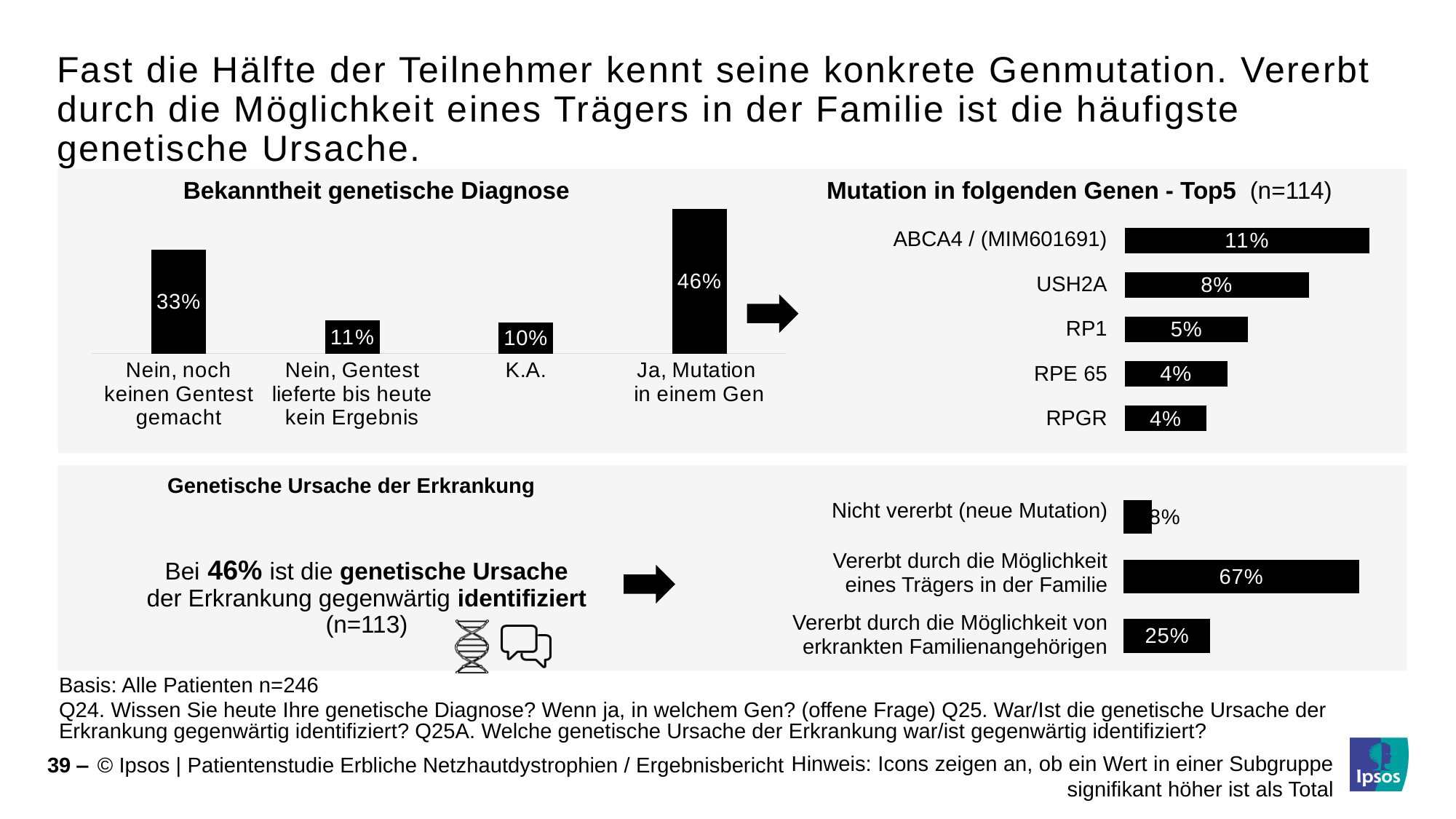
In the 'Genetische Ursache der Erkrankung' chart, which is larger: 'Vererbt durch die Möglichkeit eines Trägers in der Familie' or 'Vererbt durch die Möglichkeit von erkrankten Familienangehörigen'? Vererbt durch die Möglichkeit eines Trägers in der Familie In the 'Genetische Ursache der Erkrankung' chart, what is the value for 'Vererbt durch die Möglichkeit eines Trägers in der Familie'? 67% What sample size (n) is given in the title of the 'Mutation in folgenden Genen - Top5' chart? n=114 In the 'Mutation in folgenden Genen - Top5' chart, what is the value for USH2A? 8% What kind of chart is 'Mutation in folgenden Genen - Top5'? Bar chart In the 'Bekanntheit genetische Diagnose' chart, which category has the lowest value? K.A. How many categories are shown in the 'Bekanntheit genetische Diagnose' chart? 4 In the 'Bekanntheit genetische Diagnose' chart, what is the value for 'Ja, Mutation in einem Gen'? 46% In the 'Bekanntheit genetische Diagnose' chart, what is the value for 'Nein, noch keinen Gentest gemacht'? 33% In the 'Bekanntheit genetische Diagnose' chart, what is the difference between 'Ja, Mutation in einem Gen' and 'Nein, noch keinen Gentest gemacht'? 13 percentage points In the 'Mutation in folgenden Genen - Top5' chart, what is the difference between ABCA4 / (MIM601691) and RP1? 6 percentage points In the 'Mutation in folgenden Genen - Top5' chart, which gene has the highest value? ABCA4 / (MIM601691)